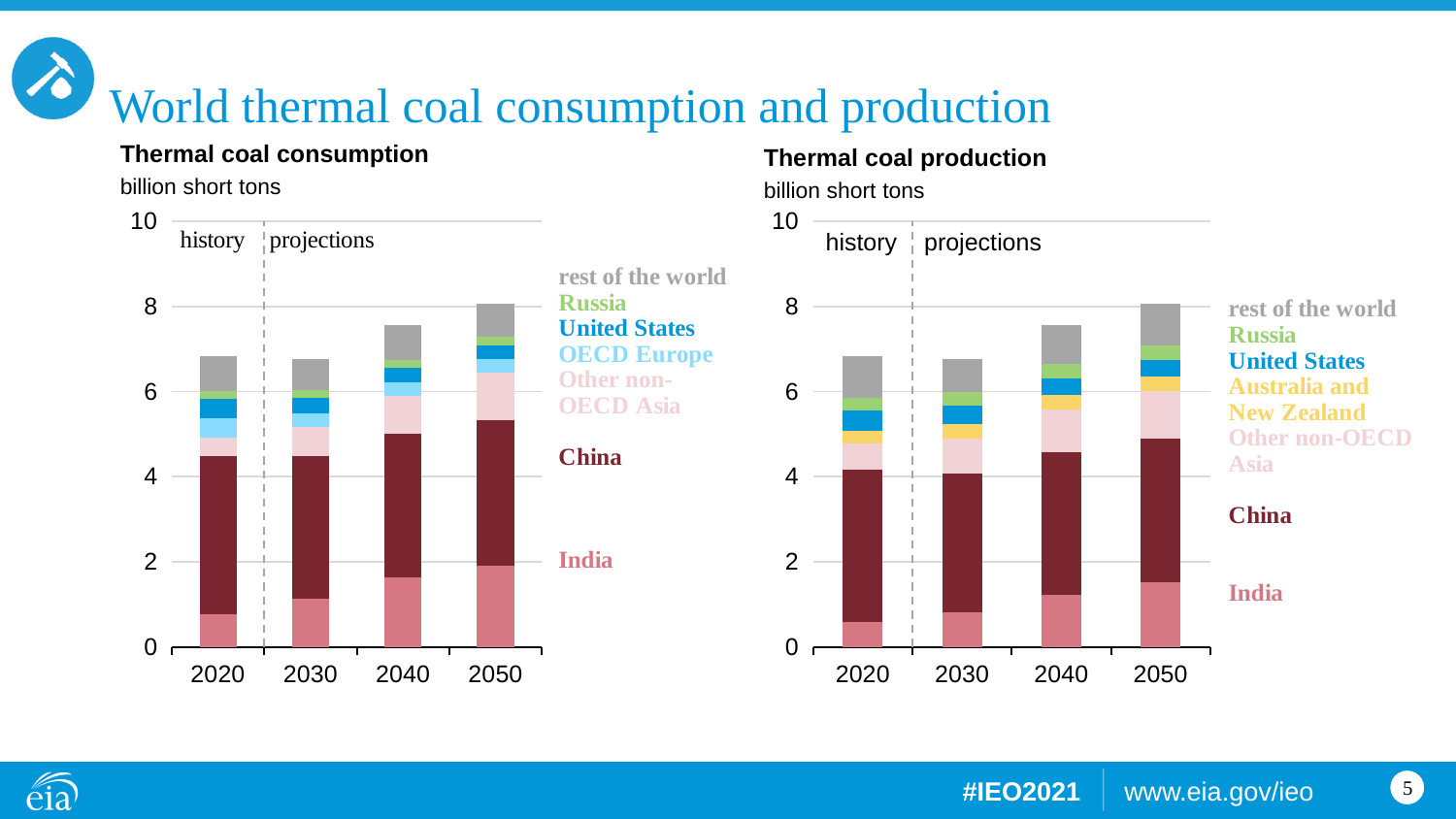
In the Thermal coal production chart, which year has the highest total bar? 2050 In the Thermal coal production chart, which total bar is larger, 2020 or 2040? 2040 In the Thermal coal production chart, how many series does the legend list? 7 In the Thermal coal consumption chart, is the India segment for 2020 greater or less than 2? less In the Thermal coal production chart, do the total bars rise or fall from 2030 to 2050? rise In the Thermal coal production chart, is the total bar for 2040 greater or less than 6? greater In the Thermal coal consumption chart, which legend entry is not present in the Thermal coal production chart's legend? OECD Europe What unit is used on the y axis of the Thermal coal production chart? billion short tons In the Thermal coal consumption chart, how many years are shown on the x axis? 4 What kind of chart is the Thermal coal consumption chart? stacked bar chart In the Thermal coal consumption chart, is the total bar for 2020 greater or less than 8? less In the Thermal coal consumption chart, which year has the highest total bar? 2050